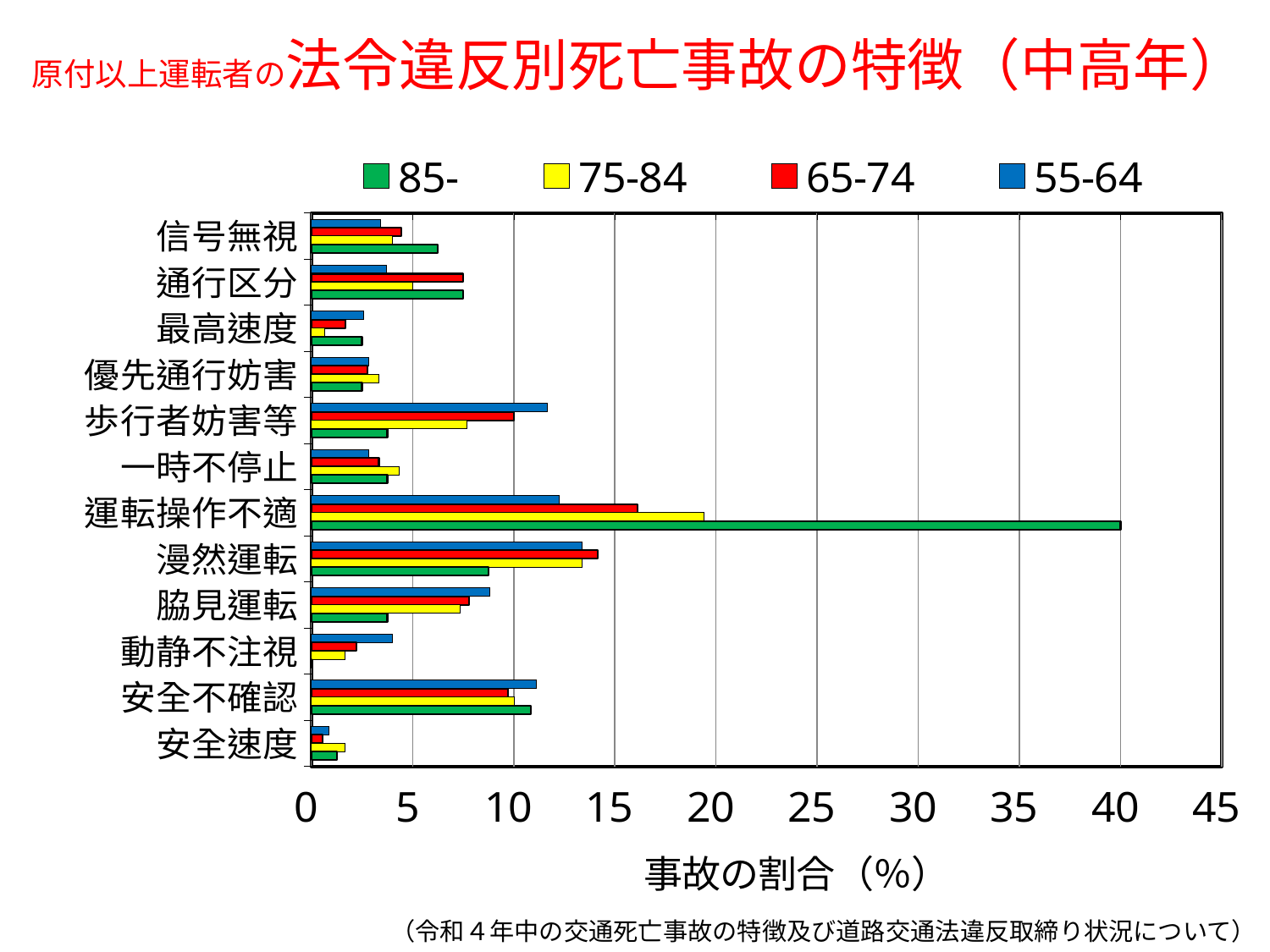
Which category has the lowest value for the 55-64 series? 安全速度 Is the value for 安全速度 in the 55-64 series greater or less than 5? less For 歩行者妨害等, which is larger: the 55-64 value or the 85- value? 55-64 What is the label of the x axis? 事故の割合（%） How many series does the legend list? 4 How many violation categories are plotted on the y axis? 12 Is the value for 運転操作不適 in the 75-84 series greater or less than 15? greater For 運転操作不適, which age series has the largest value? 85- Which category has the highest value for the 85- series? 運転操作不適 Is the value for 歩行者妨害等 in the 55-64 series greater or less than 10? greater What kind of chart is shown on the slide? bar chart